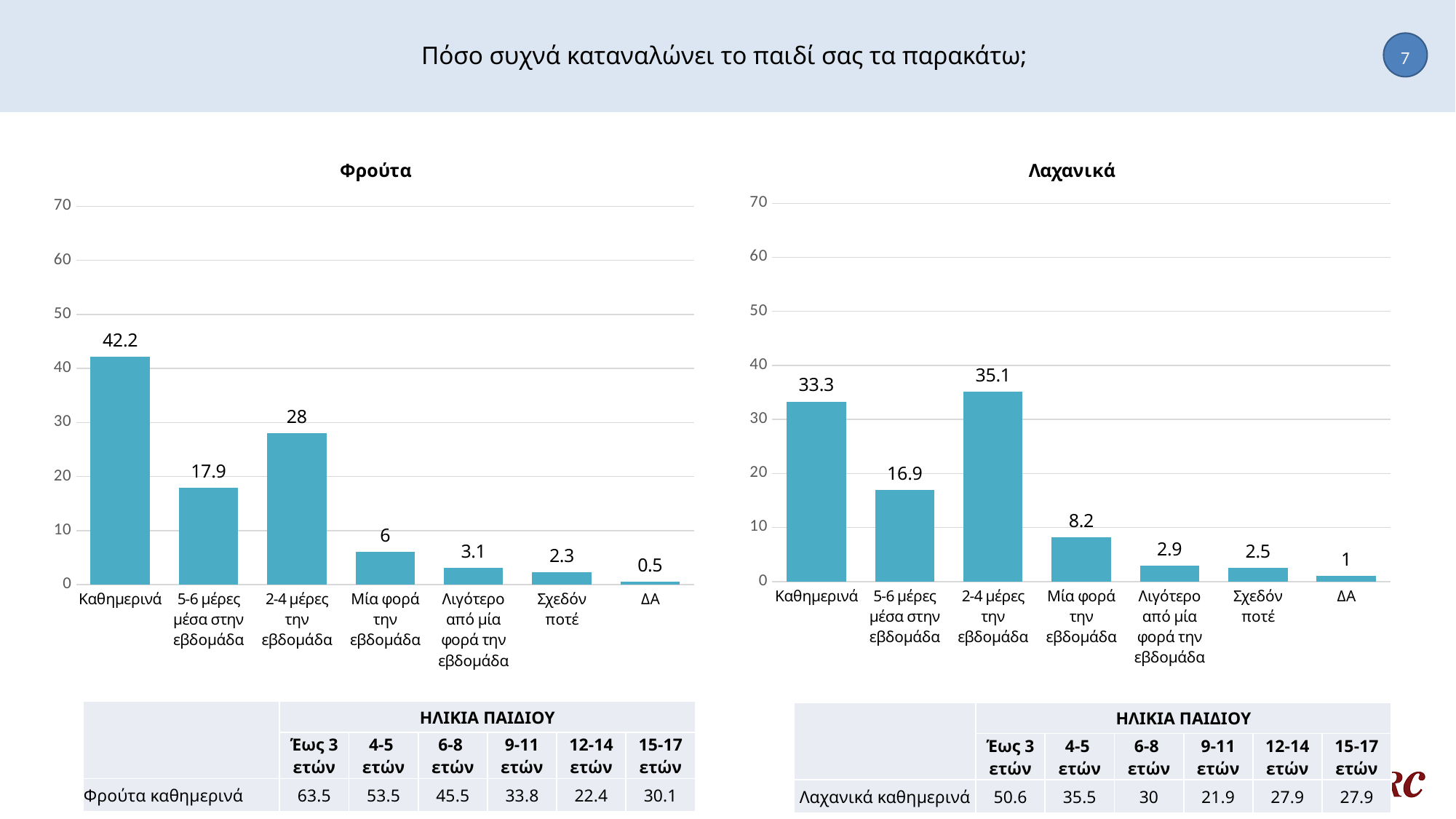
In the Φρούτα chart, what is the difference between Καθημερινά and 2-4 μέρες την εβδομάδα? 14.2 In the Φρούτα chart, what is the value for Καθημερινά? 42.2 In the Λαχανικά chart, which category has the highest value? 2-4 μέρες την εβδομάδα In the Φρούτα chart, is the value for 5-6 μέρες μέσα στην εβδομάδα greater or less than 20? less In the Λαχανικά chart, what is the difference between Καθημερινά and 5-6 μέρες μέσα στην εβδομάδα? 16.4 In the Λαχανικά chart, what is the value for 2-4 μέρες την εβδομάδα? 35.1 Which is larger: Καθημερινά in the Φρούτα chart or Καθημερινά in the Λαχανικά chart? Φρούτα In the Λαχανικά chart, which category has the lowest value? ΔΑ In the Λαχανικά chart, what is the value for Μία φορά την εβδομάδα? 8.2 How many categories are shown in the Λαχανικά chart? 7 What type of chart is the Φρούτα chart? bar chart In the Φρούτα chart, which category has the highest value? Καθημερινά